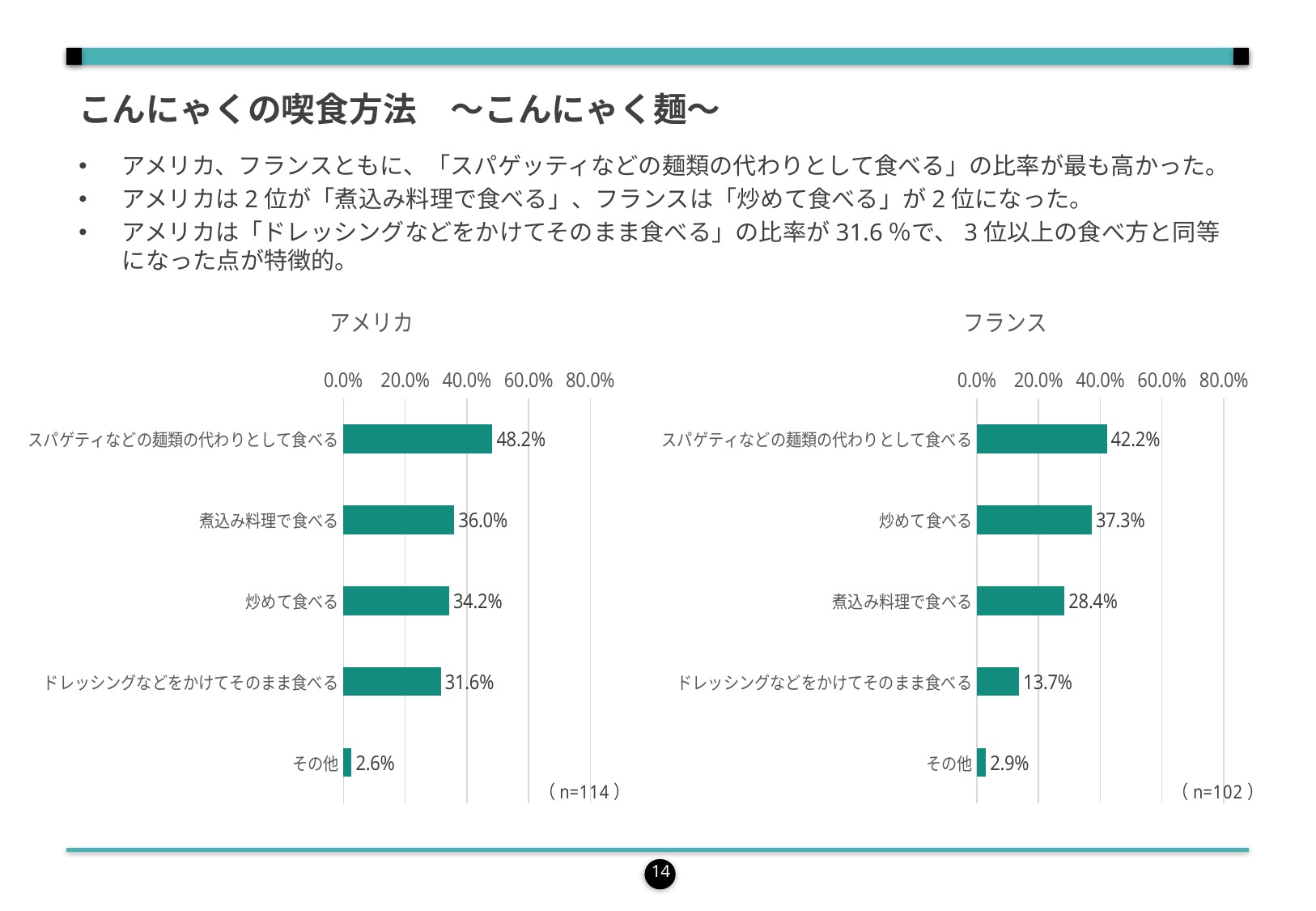
In the アメリカ chart, is the value for 炒めて食べる greater or less than 40.0%? less In the アメリカ chart, what is the difference between 煮込み料理で食べる and 炒めて食べる? 1.8% How many categories are shown in the フランス chart? 5 In the フランス chart, what is the value for ドレッシングなどをかけてそのまま食べる? 13.7% In the フランス chart, which category has the lowest value? その他 In the アメリカ chart, which category has the highest value? スパゲティなどの麺類の代わりとして食べる What kind of chart is the アメリカ chart? bar chart In the フランス chart, what is the value for 炒めて食べる? 37.3% In the フランス chart, what is the difference between スパゲティなどの麺類の代わりとして食べる and 煮込み料理で食べる? 13.8% Which is larger: ドレッシングなどをかけてそのまま食べる in the アメリカ chart or in the フランス chart? アメリカ In the アメリカ chart, what is the value for スパゲティなどの麺類の代わりとして食べる? 48.2% What is the sample size (n) shown for the フランス chart? n=102